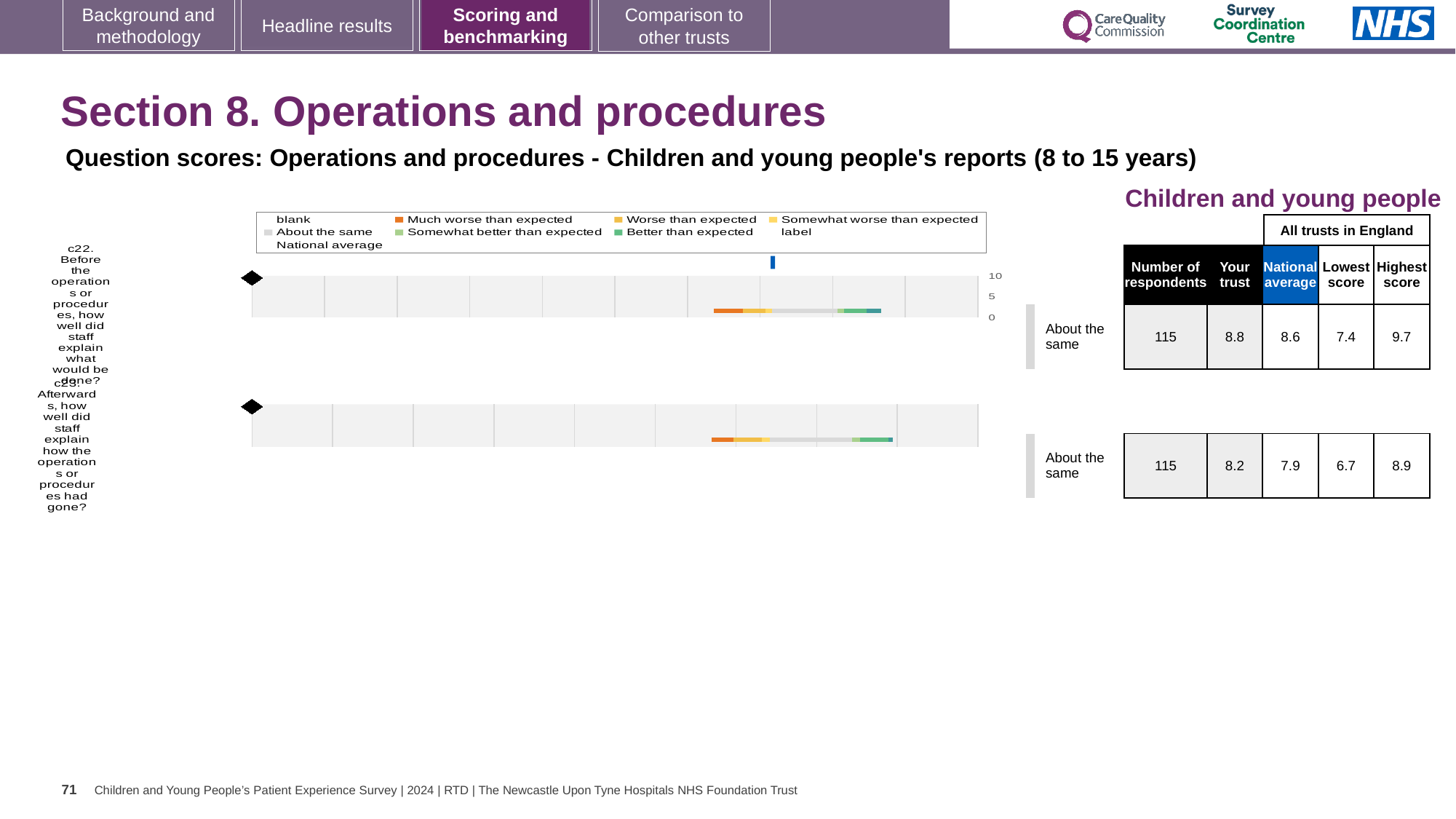
How many question charts are shown on the slide? 2 For c22 (Before the operations or procedures, how well did staff explain what would be done?), what is the 'Your trust' score? 8.8 Which question has the higher 'Your trust' score, c22 or c23? c22 For c22, what is the difference between the 'Your trust' score and the national average? 0.2 In the chart legend, what colour represents 'Much worse than expected'? Orange What benchmark category is shown for c23? About the same How many respondents answered c22? 115 For c23, what is the lowest score among all trusts in England? 6.7 For c23, which is larger: the 'Your trust' score or the national average? Your trust For c23 (Afterwards, how well did staff explain how the operations or procedures had gone?), what is the national average score? 7.9 For c22, what is the highest score among all trusts in England? 9.7 What kind of chart is used for the c22 and c23 benchmarking displays? Bar chart